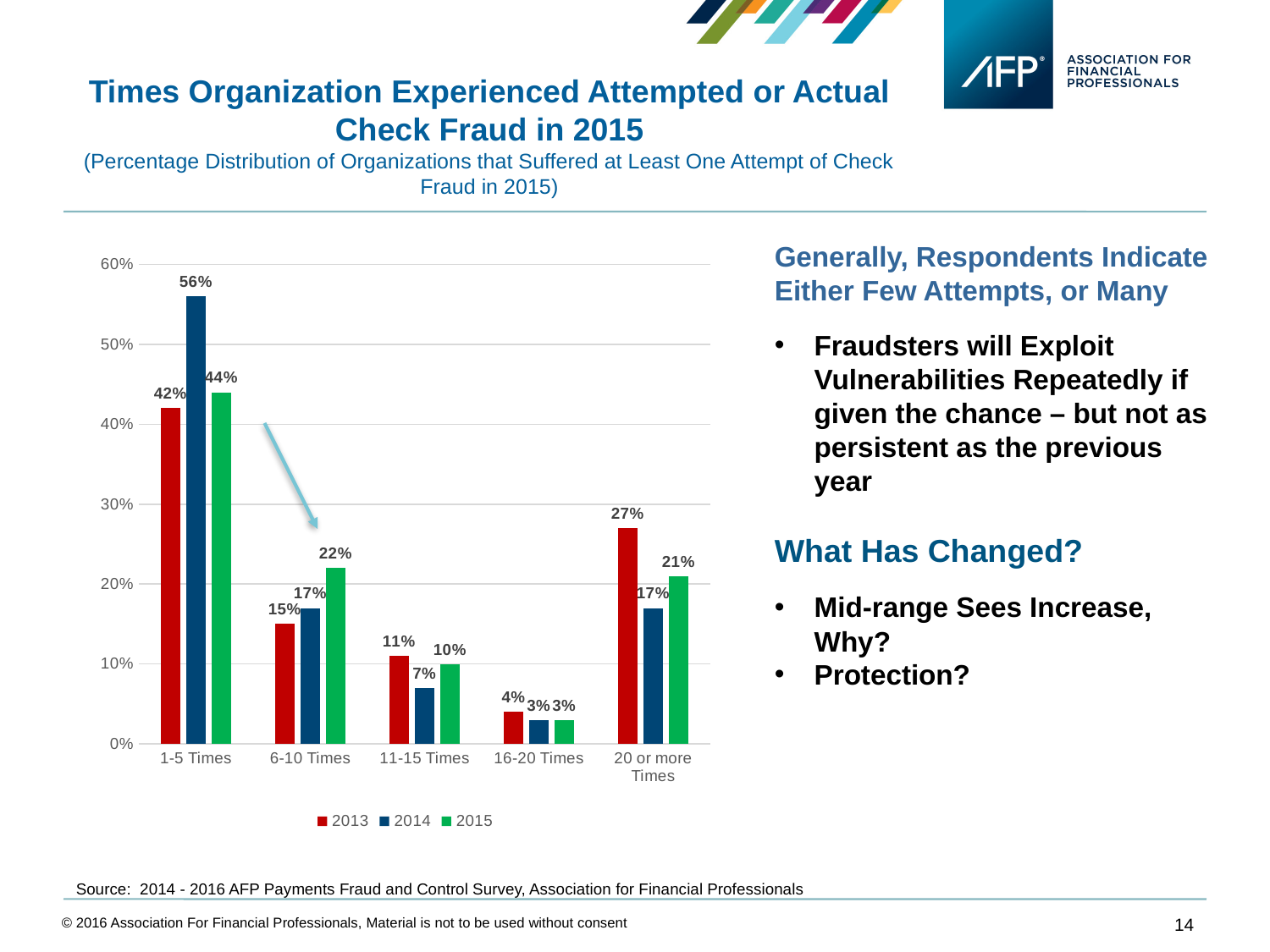
What is the difference between the 2014 and 2013 values for the 1-5 Times category? 14% Which colour represents the 2014 series in the legend? Blue How many categories are shown on the x axis? 5 Which category has the highest value for the 2015 series? 1-5 Times What is the 2015 value for the 6-10 Times category? 22% Does the 2015 series rise or fall from the 1-5 Times category to the 16-20 Times category? Fall What is the 2013 value for the 20 or more Times category? 27% What kind of chart is shown on the slide? Bar chart What percentage of organizations experienced check fraud 1-5 times in 2014? 56% Which category has the lowest value for the 2013 series? 16-20 Times Which is larger for the 11-15 Times category: the 2013 value or the 2014 value? 2013 How many series does the legend list? 3